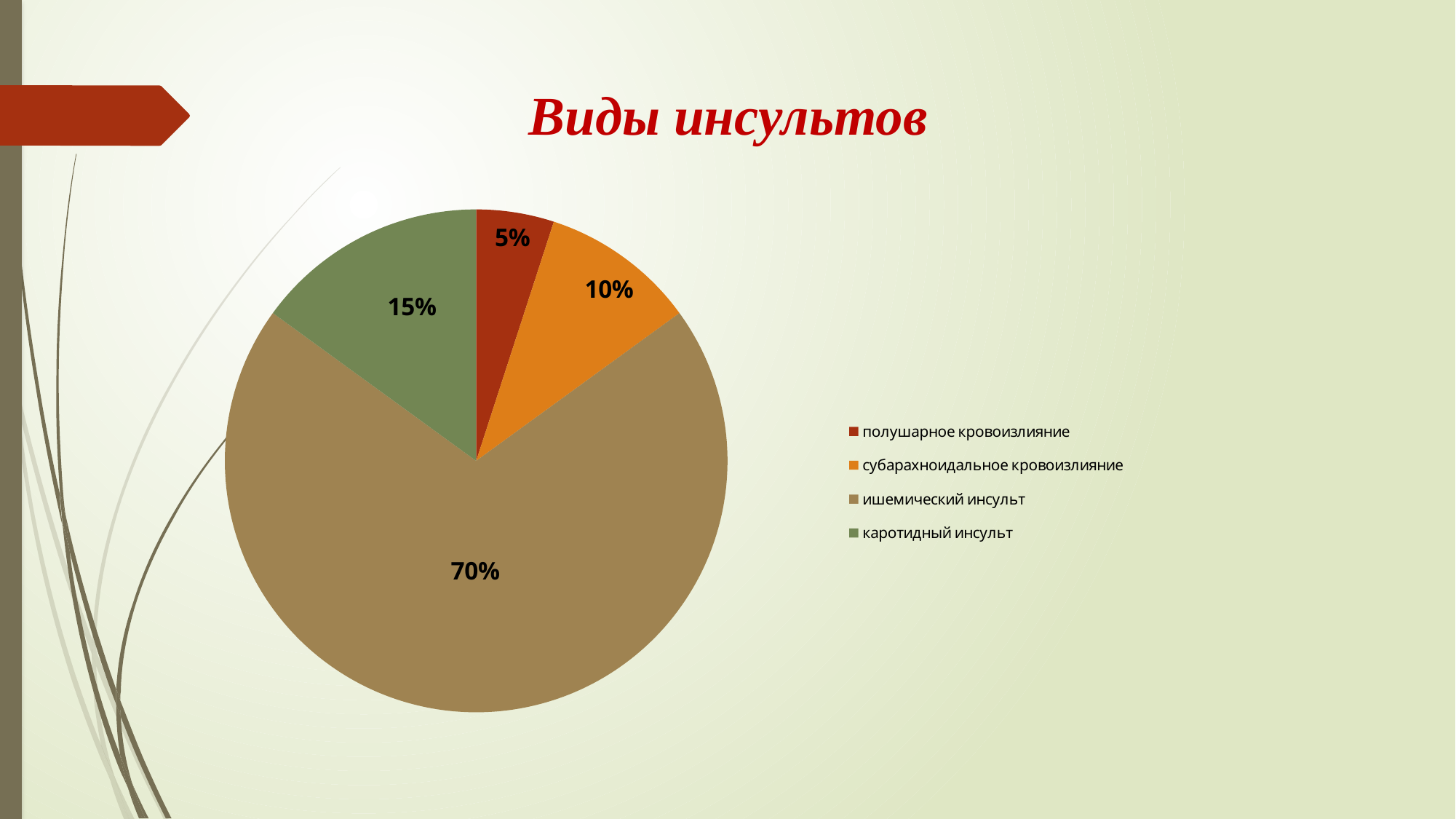
How many categories does the pie chart have? 4 What is the value for субарахноидальное кровоизлияние? 10% What is the value for каротидный инсульт? 15% Which is larger, the value for субарахноидальное кровоизлияние or the value for каротидный инсульт? каротидный инсульт What is the value for ишемический инсульт? 70% What kind of chart is shown on the slide? pie chart What is the value for полушарное кровоизлияние? 5% Which category has the largest share of the pie? ишемический инсульт What is the difference between the values for ишемический инсульт and каротидный инсульт? 55% Which category has the smallest share of the pie? полушарное кровоизлияние What is the title of the chart on the slide? Виды инсультов What colour is the slice for каротидный инсульт? green